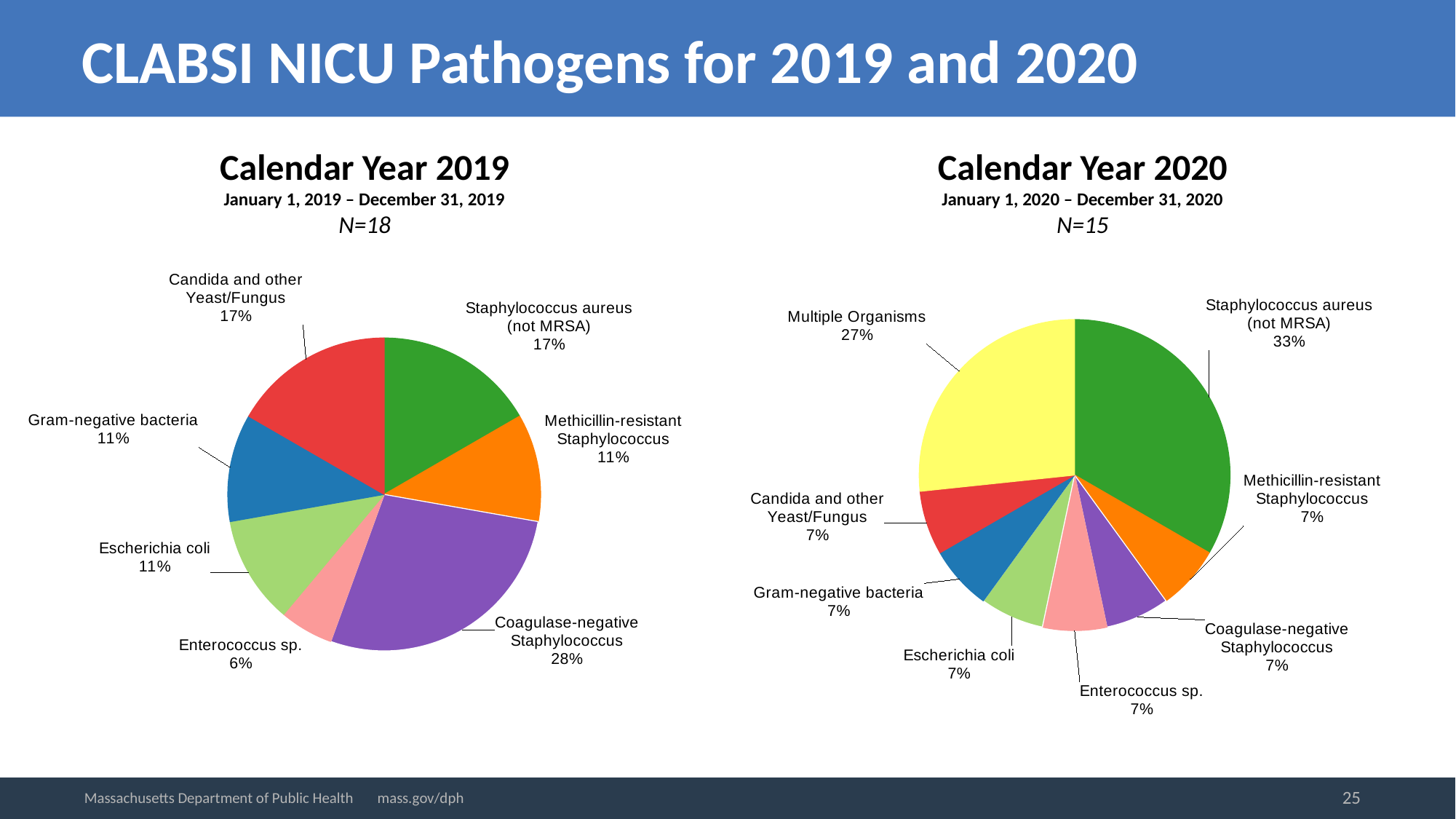
In the Calendar Year 2019 pie chart, what is the share for Candida and other Yeast/Fungus? 17% In the Calendar Year 2020 pie chart, what is the difference between the shares of Staphylococcus aureus (not MRSA) and Multiple Organisms? 6% How many slices does the Calendar Year 2019 pie chart have? 7 In the Calendar Year 2020 pie chart, what share is Staphylococcus aureus (not MRSA)? 33% What type of chart is used for Calendar Year 2019? Pie chart Which is larger: the share of Escherichia coli in the Calendar Year 2019 chart or in the Calendar Year 2020 chart? Calendar Year 2019 In the Calendar Year 2020 pie chart, which category has the largest share? Staphylococcus aureus (not MRSA) In the Calendar Year 2020 pie chart, what is the share for Multiple Organisms? 27% In the Calendar Year 2019 pie chart, which pathogen has the largest share? Coagulase-negative Staphylococcus How many slices does the Calendar Year 2020 pie chart have? 8 In the Calendar Year 2019 pie chart, which pathogen has the smallest share? Enterococcus sp. In the Calendar Year 2019 pie chart, what share is Coagulase-negative Staphylococcus? 28%